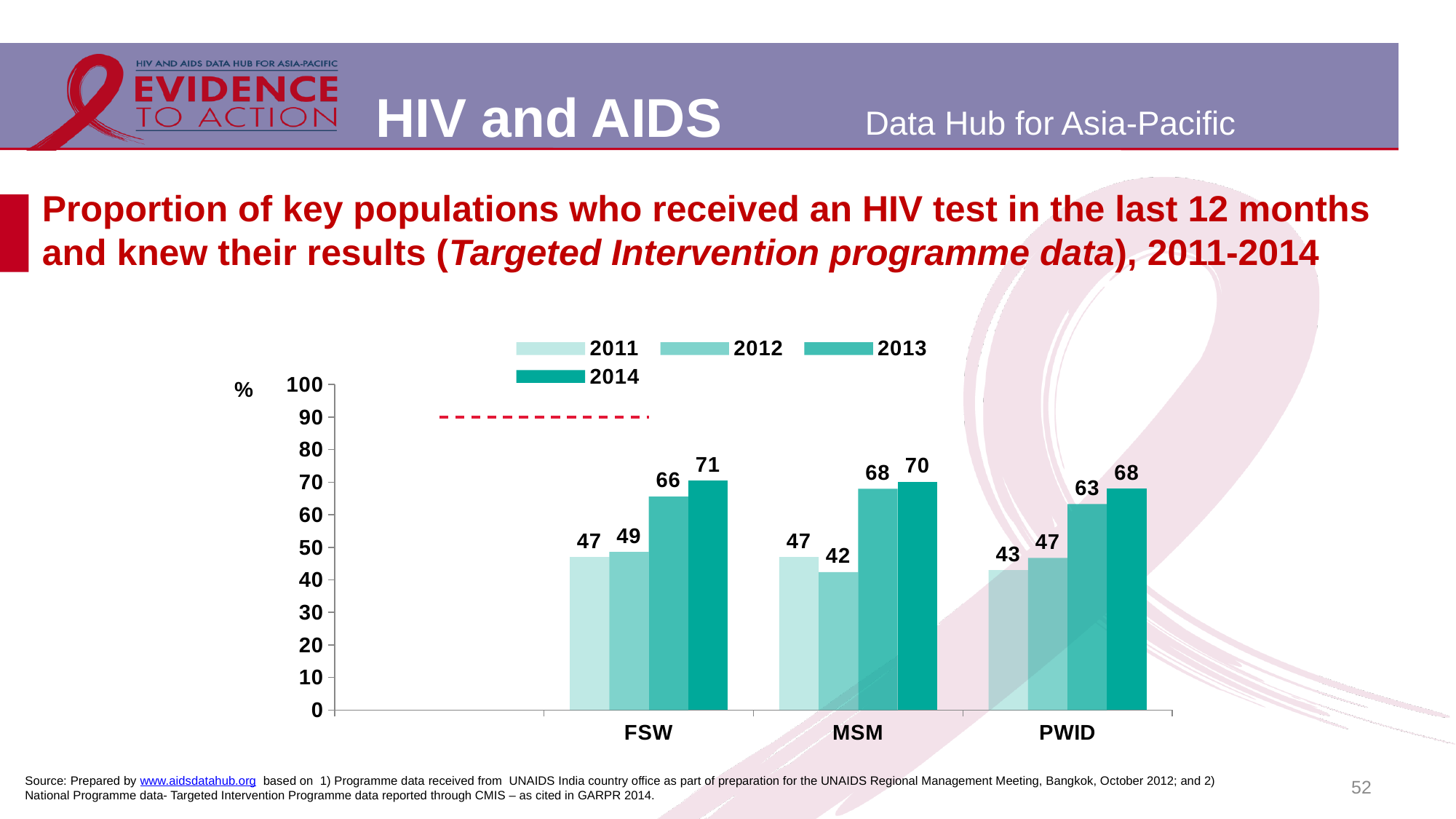
For FSW, do the values rise or fall from 2011 to 2014? Rise What unit label is shown on the y axis? % What is the difference between the 2014 and 2011 values for PWID? 25 How many key population categories are shown on the x axis? 3 How many series does the legend list? 4 Which key population has the highest value in 2014? FSW What kind of chart is shown on the slide? Bar chart What is the value for PWID in 2013? 63 Which key population has the lowest value in 2012? MSM What is the value for FSW in 2014? 71 Which is larger for MSM: the 2011 value or the 2012 value? 2011 What is the value for MSM in 2012? 42